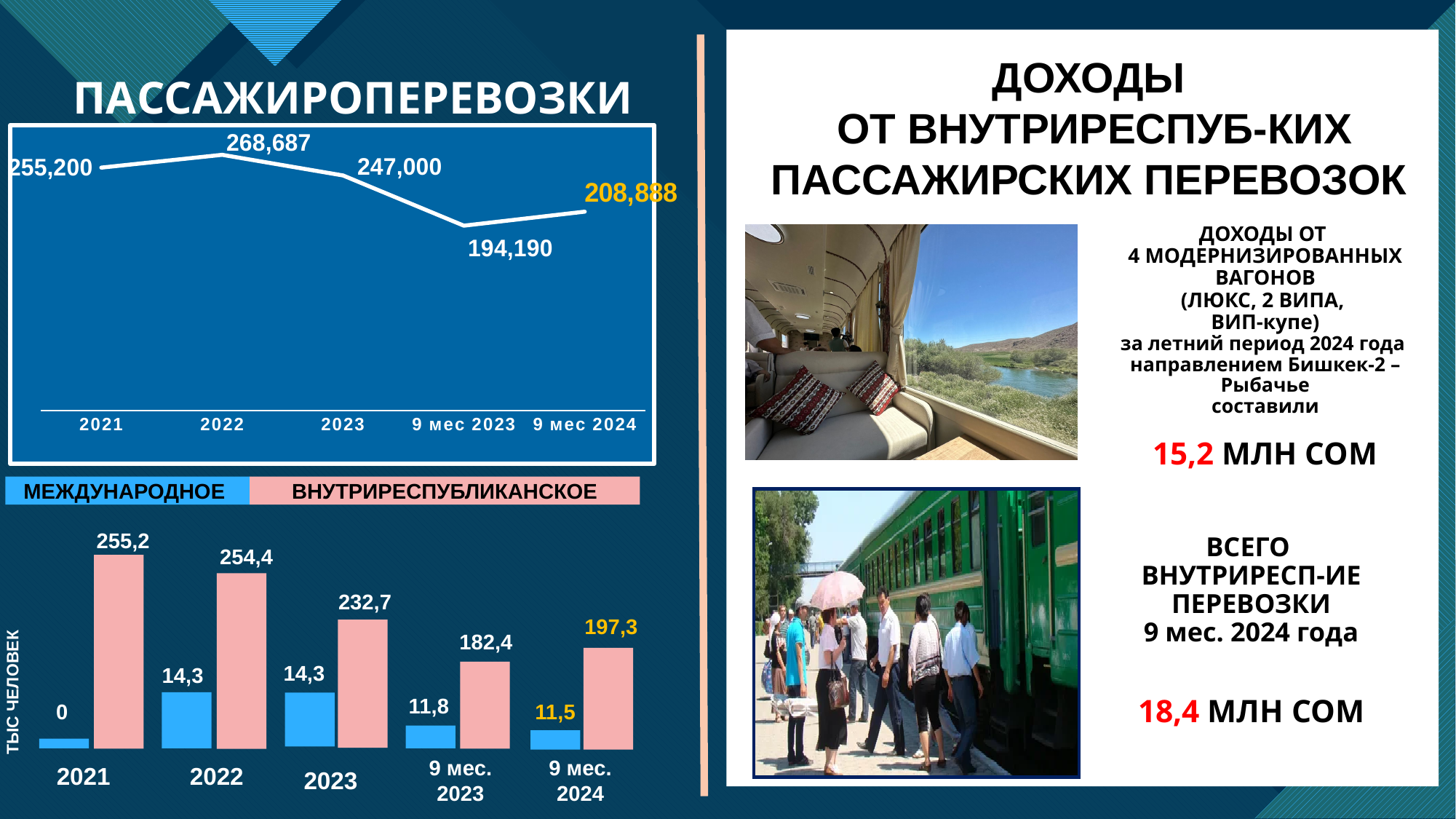
In the bottom bar chart, which is larger for 9 мес. 2023: МЕЖДУНАРОДНОЕ or ВНУТРИРЕСПУБЛИКАНСКОЕ? ВНУТРИРЕСПУБЛИКАНСКОЕ In the bottom bar chart, what is the МЕЖДУНАРОДНОЕ value for 9 мес. 2024? 11,5 In the top line chart, how many data points are plotted? 5 In the bottom bar chart, how many series does the legend list? 2 In the top line chart, which category has the highest value? 2022 In the top line chart, what is the value for 2022? 268,687 In the bottom bar chart, what colour represents the МЕЖДУНАРОДНОЕ series? blue In the top line chart, what is the value for 9 мес 2024? 208,888 In the top line chart, which category has the lowest value? 9 мес 2023 What kind of chart is the top chart on the slide? line chart In the bottom bar chart, which year has the highest ВНУТРИРЕСПУБЛИКАНСКОЕ value? 2021 In the bottom bar chart, what is the ВНУТРИРЕСПУБЛИКАНСКОЕ value for 2023? 232,7